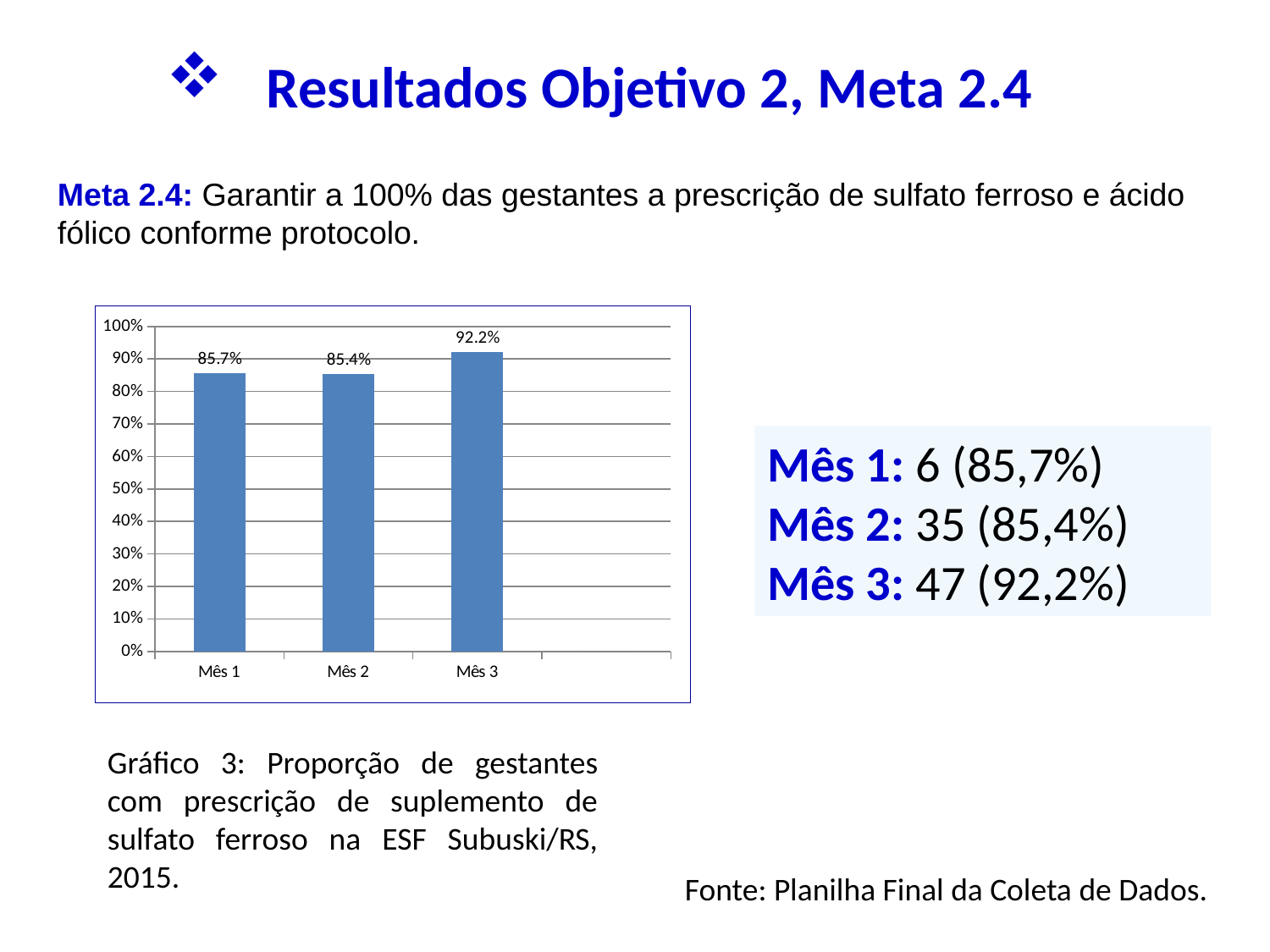
What is the difference between the values for Mês 3 and Mês 1? 6.5 percentage points What is the value for Mês 3 in the bar chart? 92.2% What is the value for Mês 1 in the bar chart? 85.7% What is the difference between the values for Mês 3 and Mês 2? 6.8 percentage points Which month has the highest value in the bar chart? Mês 3 Is the value for Mês 1 greater or less than 90%? less What kind of chart is shown on the slide? Bar chart Which month has the lowest value in the bar chart? Mês 2 Which is larger, the value for Mês 3 or the value for Mês 1? Mês 3 Is the value for Mês 3 greater or less than 90%? greater How many months are shown on the x axis of the chart? 3 What is the value for Mês 2 in the bar chart? 85.4%